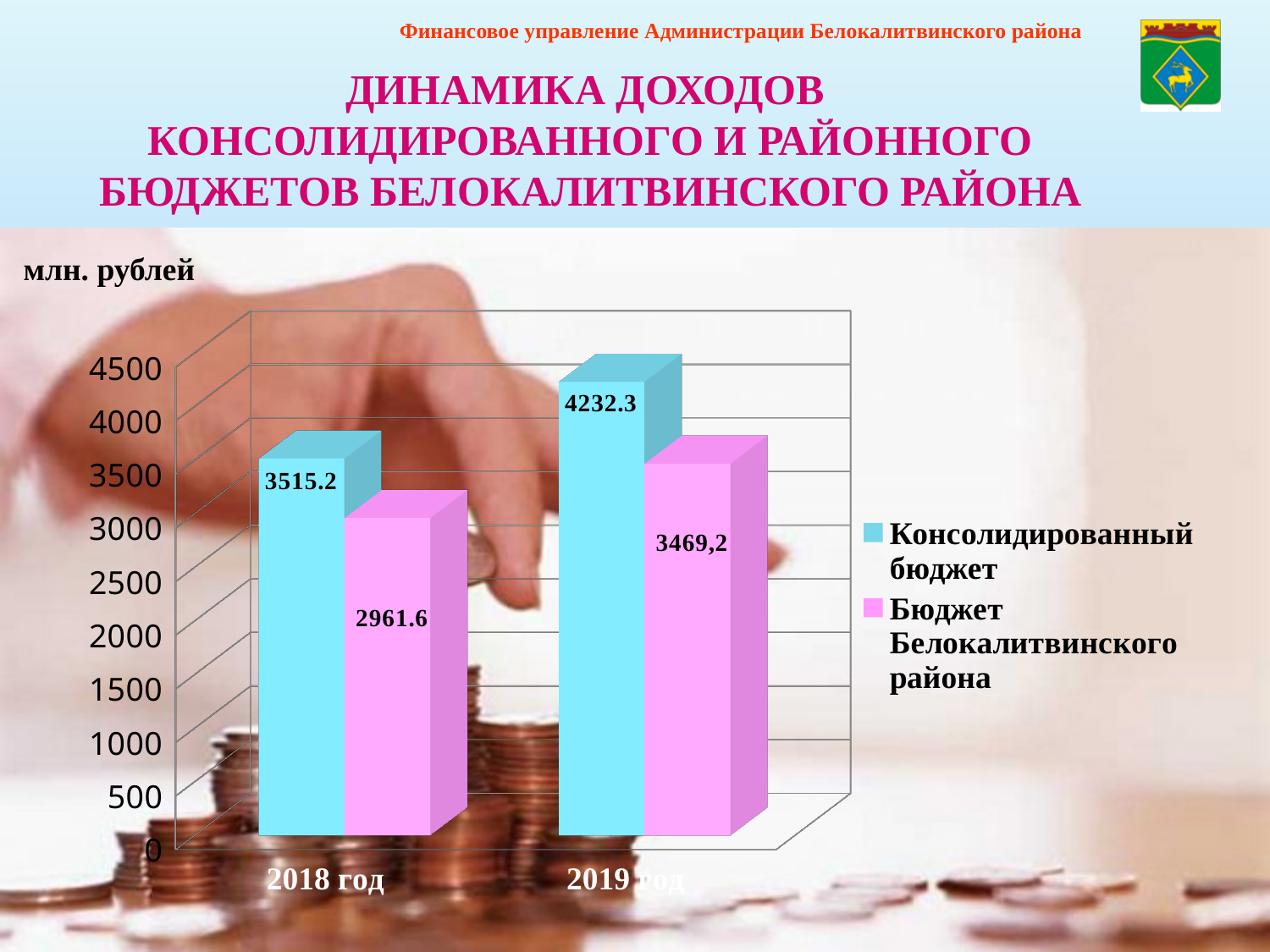
Which year has the lowest value for Бюджет Белокалитвинского района? 2018 год Which is larger in 2018 год: Консолидированный бюджет or Бюджет Белокалитвинского района? Консолидированный бюджет What is the value for Бюджет Белокалитвинского района in 2019 год? 3469,2 What is the value for Консолидированный бюджет in 2018 год? 3515.2 Do the values for Бюджет Белокалитвинского района rise or fall from 2018 год to 2019 год? Rise How many series does the legend list? 2 How many year categories are shown on the x axis? 2 What is the difference between the Консолидированный бюджет values for 2019 год and 2018 год? 717.1 What is the value for Бюджет Белокалитвинского района in 2018 год? 2961.6 What is the value for Консолидированный бюджет in 2019 год? 4232.3 Which year has the highest value for Консолидированный бюджет? 2019 год What kind of chart is shown on the slide? Bar chart